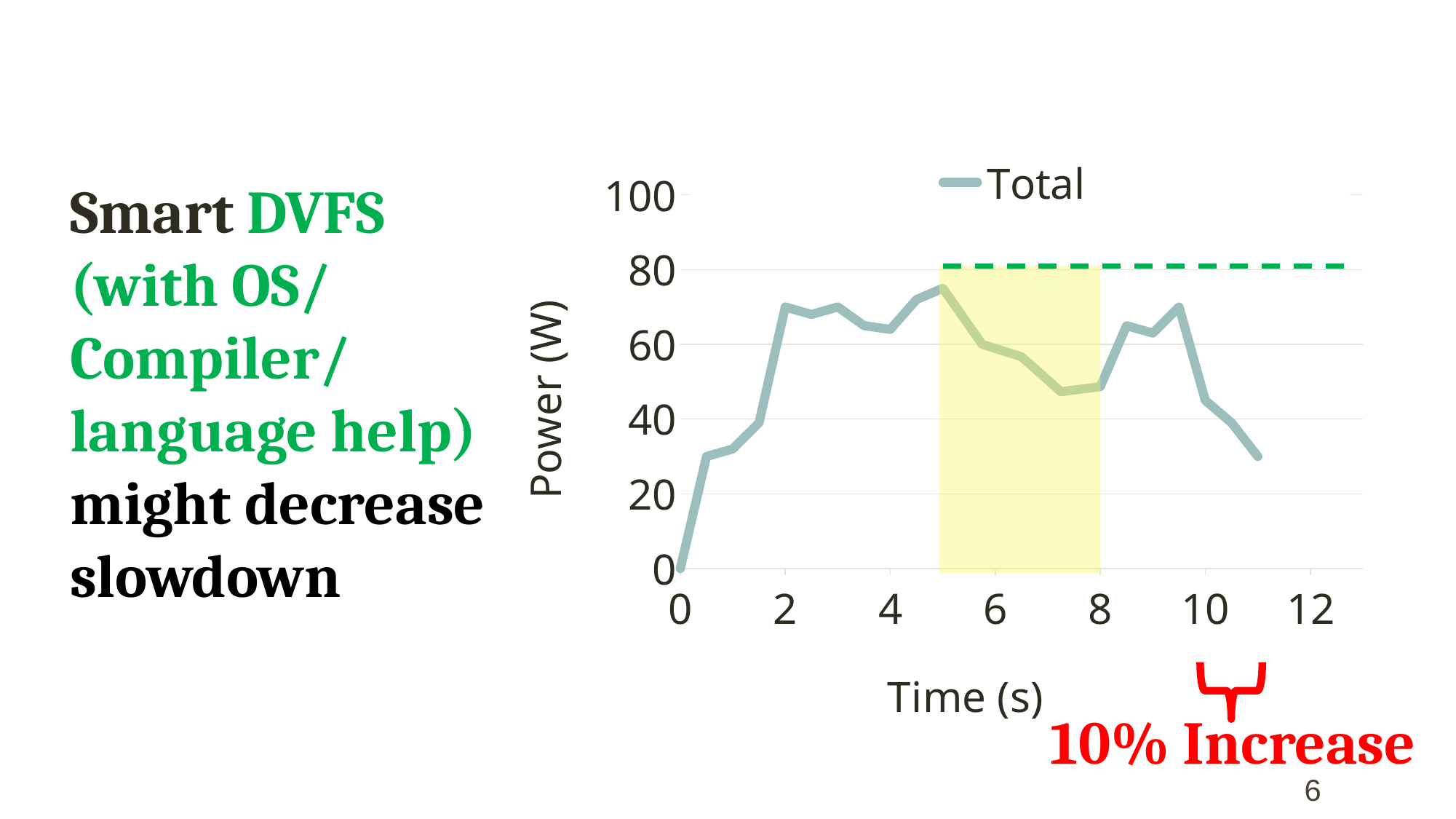
Is the value of Total at time 11 greater or less than 40? less How many series does the legend list? 1 Which is larger, the value of Total at time 2 or at time 11? time 2 What is the value of Total at time 0? 0 What is the label of the vertical axis? Power (W) Between time 0 and time 2, does the Total line rise or fall? rise Is the value of Total at time 7 greater or less than 60? less Between time 5 and time 7, does the Total line rise or fall? fall Is the value of Total at time 2 greater or less than 60? greater What is the name of the series shown in the legend? Total What kind of chart is shown on the slide? line chart